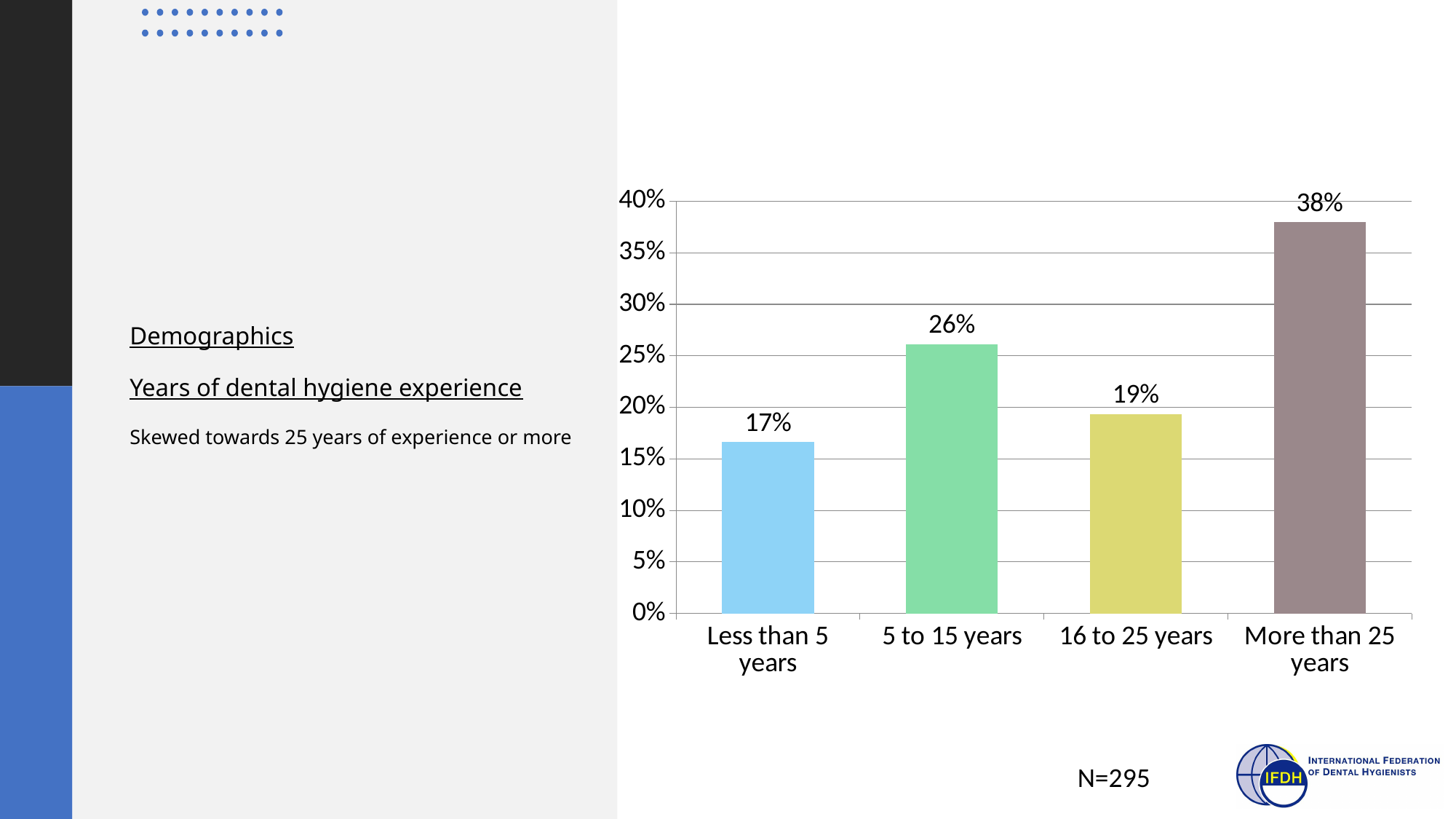
What percentage of respondents have more than 25 years of experience? 38% What percentage of respondents have less than 5 years of dental hygiene experience? 17% Which is larger: the percentage for '5 to 15 years' or for '16 to 25 years'? 5 to 15 years Which experience category has the highest percentage? More than 25 years What is the difference in percentage points between the 'More than 25 years' and '5 to 15 years' categories? 12 What percentage of respondents have 16 to 25 years of experience? 19% What percentage of respondents have 5 to 15 years of experience? 26% What is the sample size (N) stated on the slide? N=295 Which experience category has the lowest percentage? Less than 5 years What type of chart is used to show years of dental hygiene experience? Bar chart How many experience categories are shown in the chart? 4 Is the value for 'More than 25 years' greater or less than 35%? greater